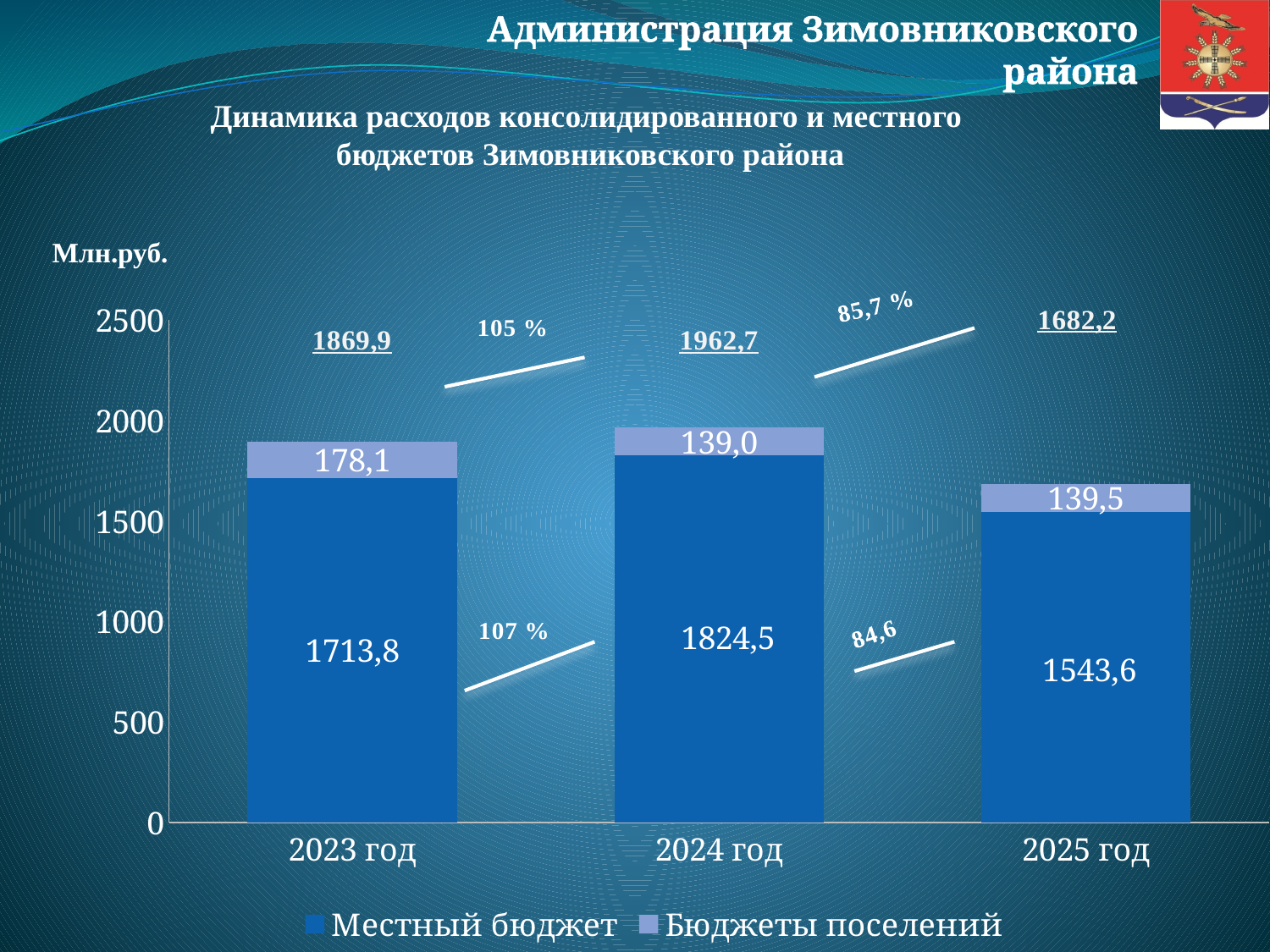
In which year is Местный бюджет the highest? 2024 год Which is larger: Бюджеты поселений in 2023 год or in 2024 год? 2023 год What is the value of Местный бюджет for 2025 год? 1543,6 In which year is Бюджеты поселений the highest? 2023 год What value is printed above the bar for 2024 год? 1962,7 How many years are shown on the x axis? 3 How many series does the legend list? 2 What is the value of Местный бюджет for 2024 год? 1824,5 What is the difference between Местный бюджет in 2024 год and 2023 год? 110,7 In which year is Местный бюджет the lowest? 2025 год What kind of chart is shown on the slide? Stacked bar chart What is the value of Бюджеты поселений for 2023 год? 178,1